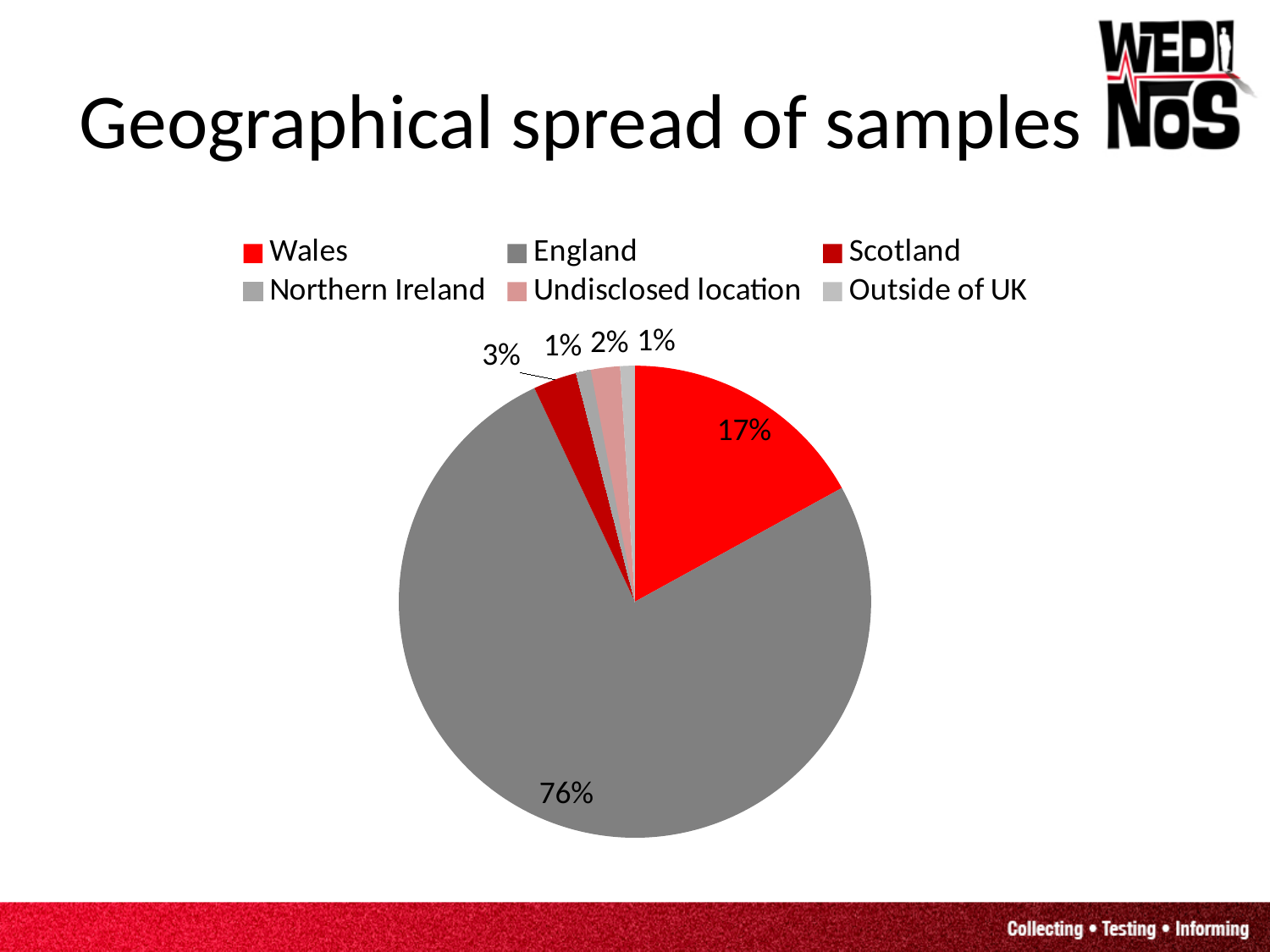
What is the title of the chart on the slide? Geographical spread of samples How many categories does the legend list? 6 What share of samples came from England? 76% Which region accounts for the largest share of samples? England What share of samples came from Wales? 17% What colour is the slice representing Wales? Red What share of samples came from an undisclosed location? 2% What is the difference in percentage points between England's share and Wales's share? 59 What type of chart is shown on the slide? Pie chart Which has a larger share of samples, Scotland or Undisclosed location? Scotland What share of samples came from Scotland? 3% What share of samples came from Northern Ireland? 1%